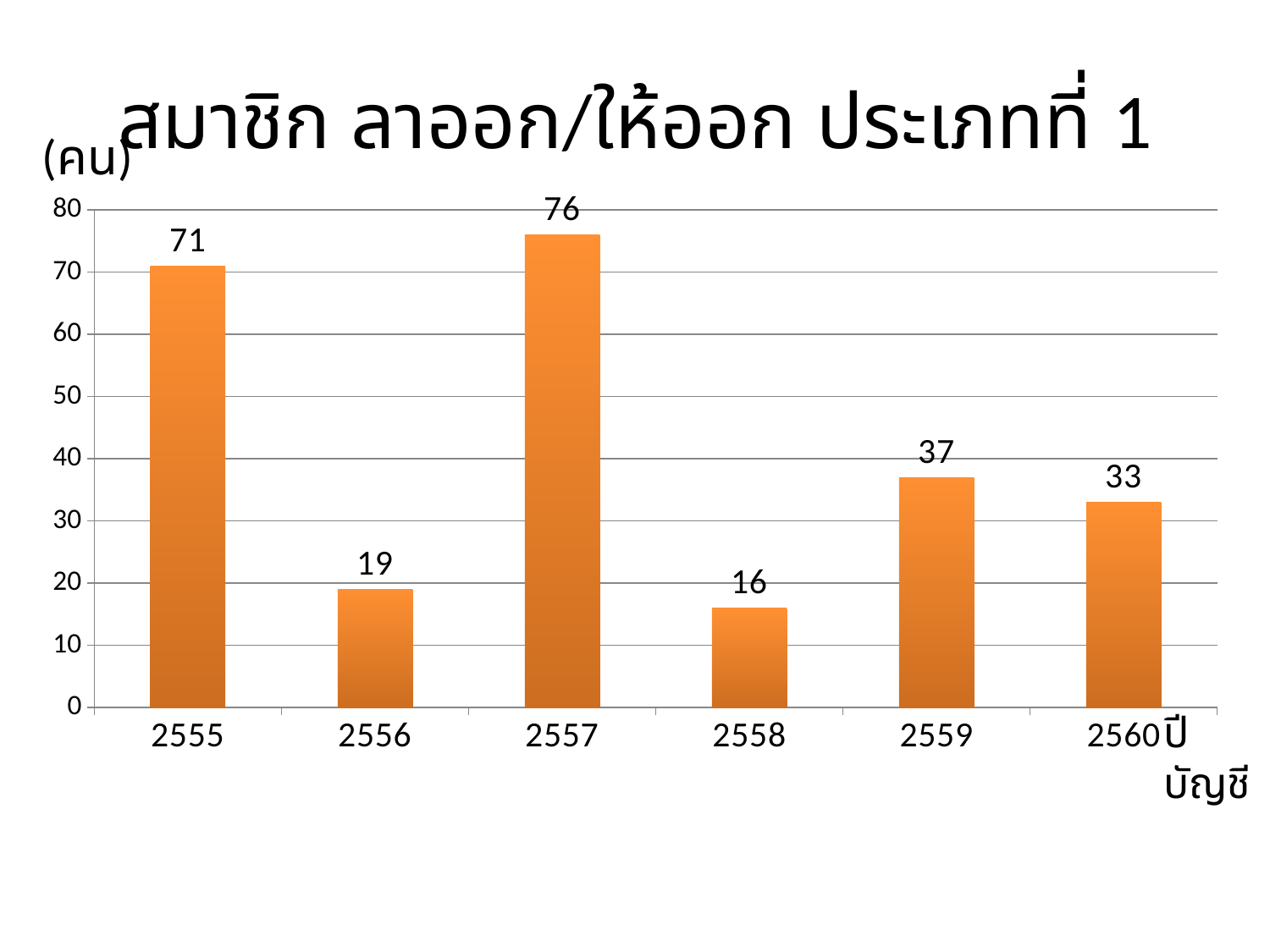
What is the difference between the values for 2559 and 2560? 4 How many years are shown on the x axis? 6 Which year has the lowest value? 2558 What is the difference between the values for 2557 and 2556? 57 What is the title of the chart? สมาชิก ลาออก/ให้ออก ประเภทที่ 1 Which is larger, the value for 2555 or the value for 2557? 2557 Is the value for 2559 greater or less than 30? greater What is the value for 2560? 33 What is the value for 2555? 71 What is the value for 2558? 16 What kind of chart is shown on the slide? bar chart Which year has the highest value? 2557